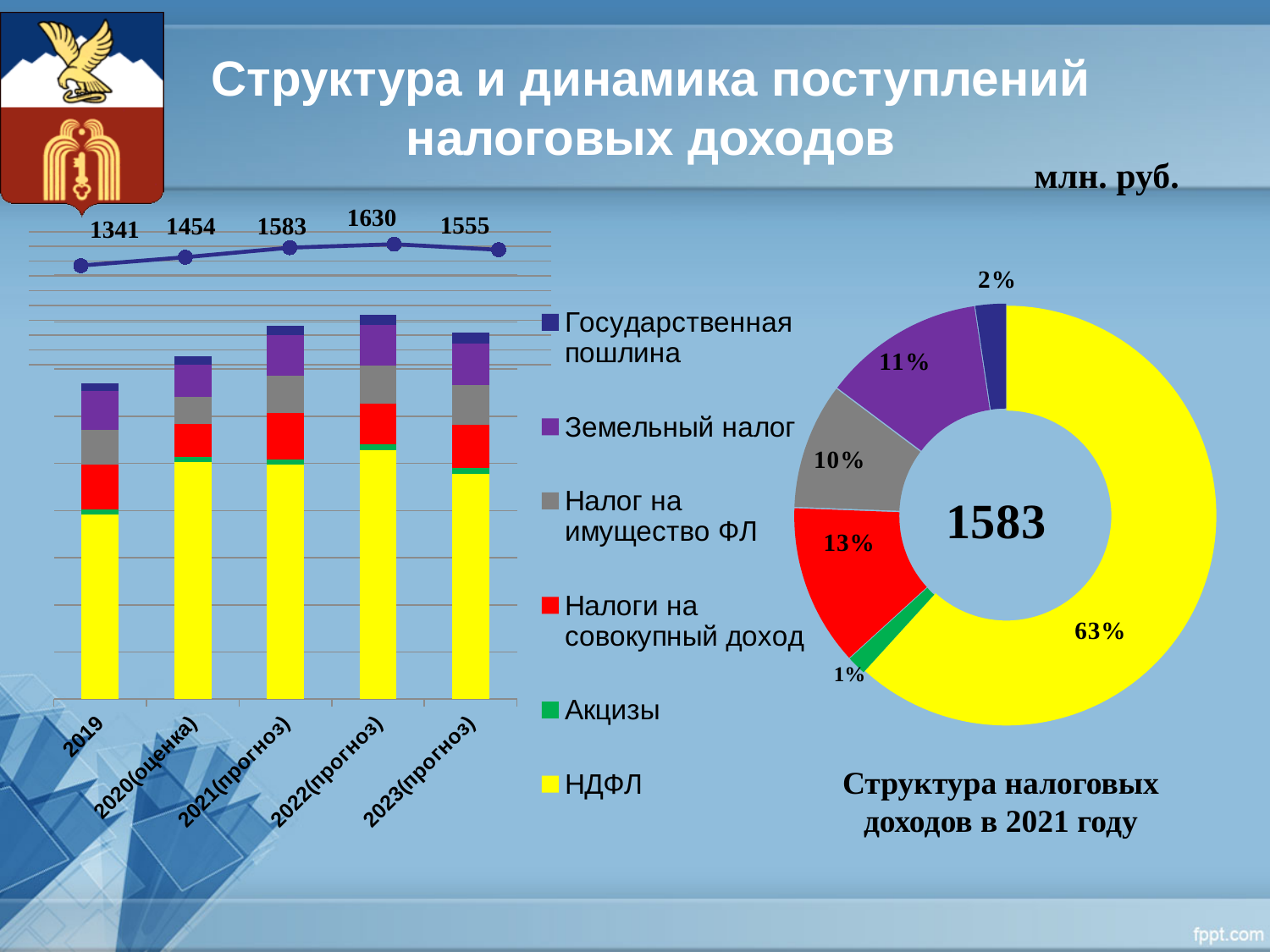
On the left chart, how many years (categories) are shown on the x axis? 5 What kind of chart is the chart titled 'Структура налоговых доходов в 2021 году'? Pie (donut) chart On the left chart, which year has the lowest total value on the line? 2019 On the left chart, what is the total tax revenue value shown for 2022(прогноз)? 1630 On the left chart, what is the difference between the values for 2022(прогноз) and 2023(прогноз)? 75 On the chart 'Структура налоговых доходов в 2021 году', which category has the smallest share? Акцизы On the left chart, what value is shown for 2019? 1341 On the left chart, do the line values rise or fall from 2019 to 2022(прогноз)? Rise How many series does the legend of the left chart list? 6 On the chart 'Структура налоговых доходов в 2021 году', what share does НДФЛ have? 63% On the left chart, which is larger: the value for 2020(оценка) or for 2021(прогноз)? 2021(прогноз) On the left chart, which year has the highest total value on the line? 2022(прогноз)